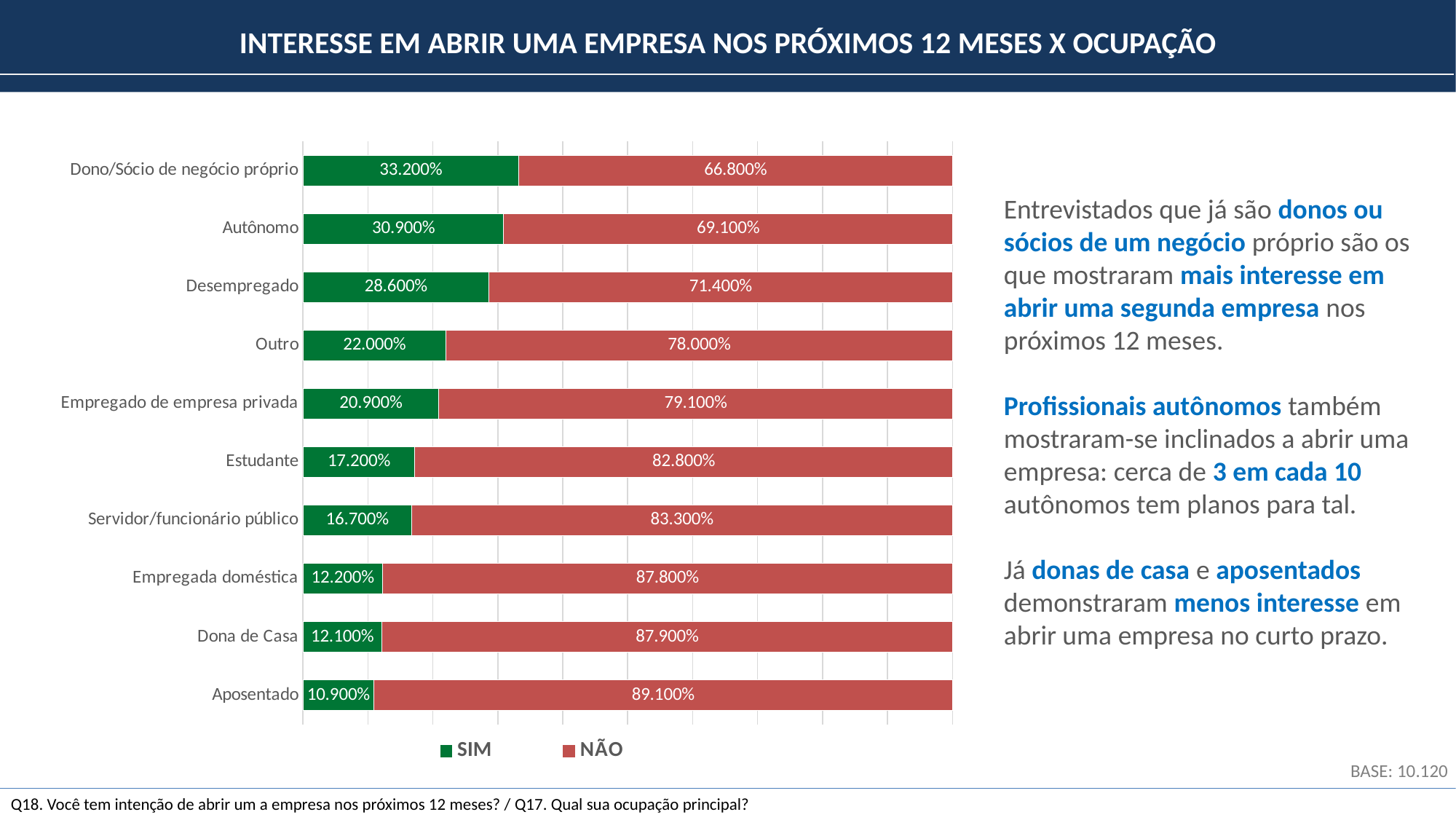
What is the SIM value for Aposentado? 10.900% What is the NÃO value for Estudante? 82.800% Which occupation has the highest SIM value? Dono/Sócio de negócio próprio What is the SIM value for Dono/Sócio de negócio próprio? 33.200% How many series does the legend list? 2 How many occupation categories are shown in the chart? 10 Which has a larger NÃO value, Outro or Empregado de empresa privada? Empregado de empresa privada What is the total of the stacked bar for Servidor/funcionário público? 100.000% What kind of chart is shown on the slide? Stacked bar chart What is the difference between the SIM values for Autônomo and Desempregado? 2.300% Which colour represents the SIM series in the chart? Green Which occupation has the lowest SIM value? Aposentado